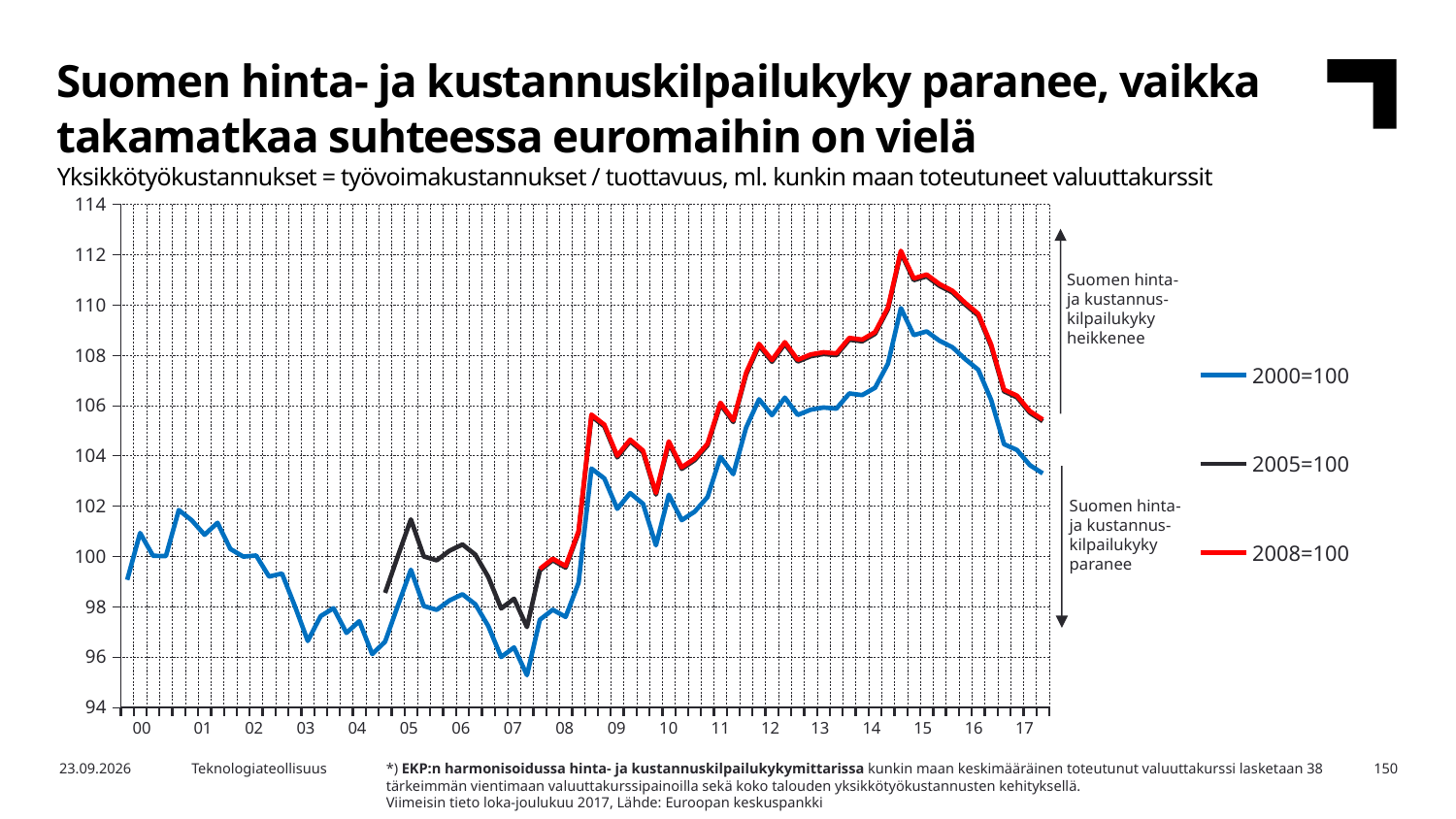
Is the value of the 2000=100 series at the end of 2017 greater or less than 104? less What kind of chart is shown on the slide? line chart Which colour is used for the 2008=100 series? red What are the three series named in the legend? 2000=100, 2005=100, 2008=100 What is the highest value shown on the vertical axis? 114 In which year does the 2000=100 series reach its lowest value? 07 Is the peak value of the 2000=100 series in 2015 greater or less than 108? greater How many series does the legend list? 3 Does the 2000=100 series rise or fall between 2015 and 2017? fall In which year does the 2000=100 series reach its highest value? 15 Is the peak value of the 2008=100 series in 2015 greater or less than 110? greater At the end of 2017, which series is higher: 2000=100 or 2008=100? 2008=100